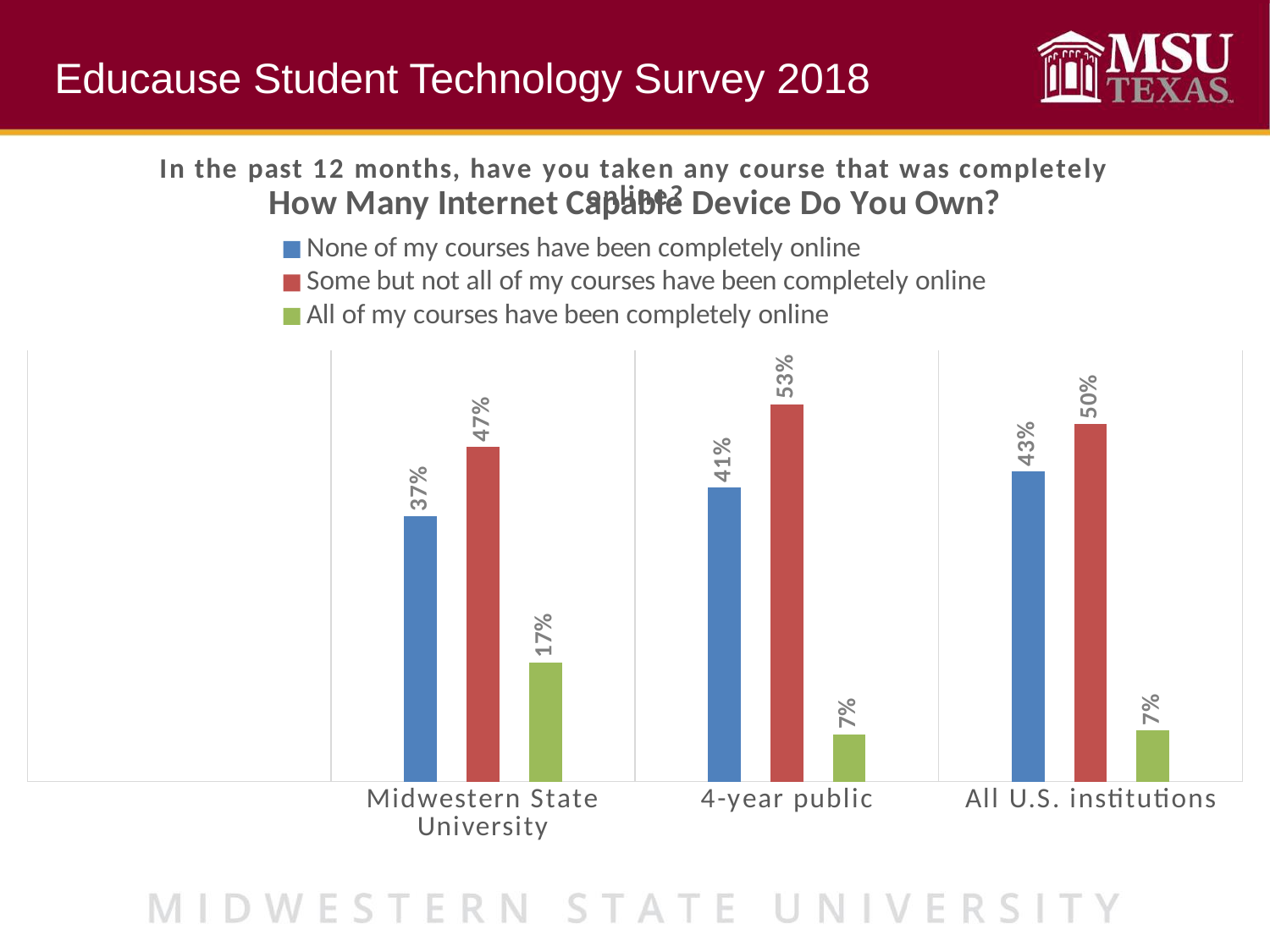
How many series does the legend list? 3 How many institution categories are shown on the x axis? 3 What percentage of students at all U.S. institutions said all of their courses have been completely online? 7% What kind of chart is shown on the slide? Bar chart Which institution category has the highest value for 'Some but not all of my courses have been completely online'? 4-year public What is the difference between the 'Some but not all' value for 4-year public and for Midwestern State University? 6% What is the value for 'All of my courses have been completely online' at Midwestern State University? 17% What is the difference between the 'All of my courses' value for Midwestern State University and for 4-year public? 10% What percentage of Midwestern State University students said none of their courses have been completely online? 37% Which institution category has the lowest value for 'None of my courses have been completely online'? Midwestern State University What is the value for 'Some but not all of my courses have been completely online' for 4-year public institutions? 53% Which is larger: the 'None of my courses' value for all U.S. institutions or for 4-year public? All U.S. institutions